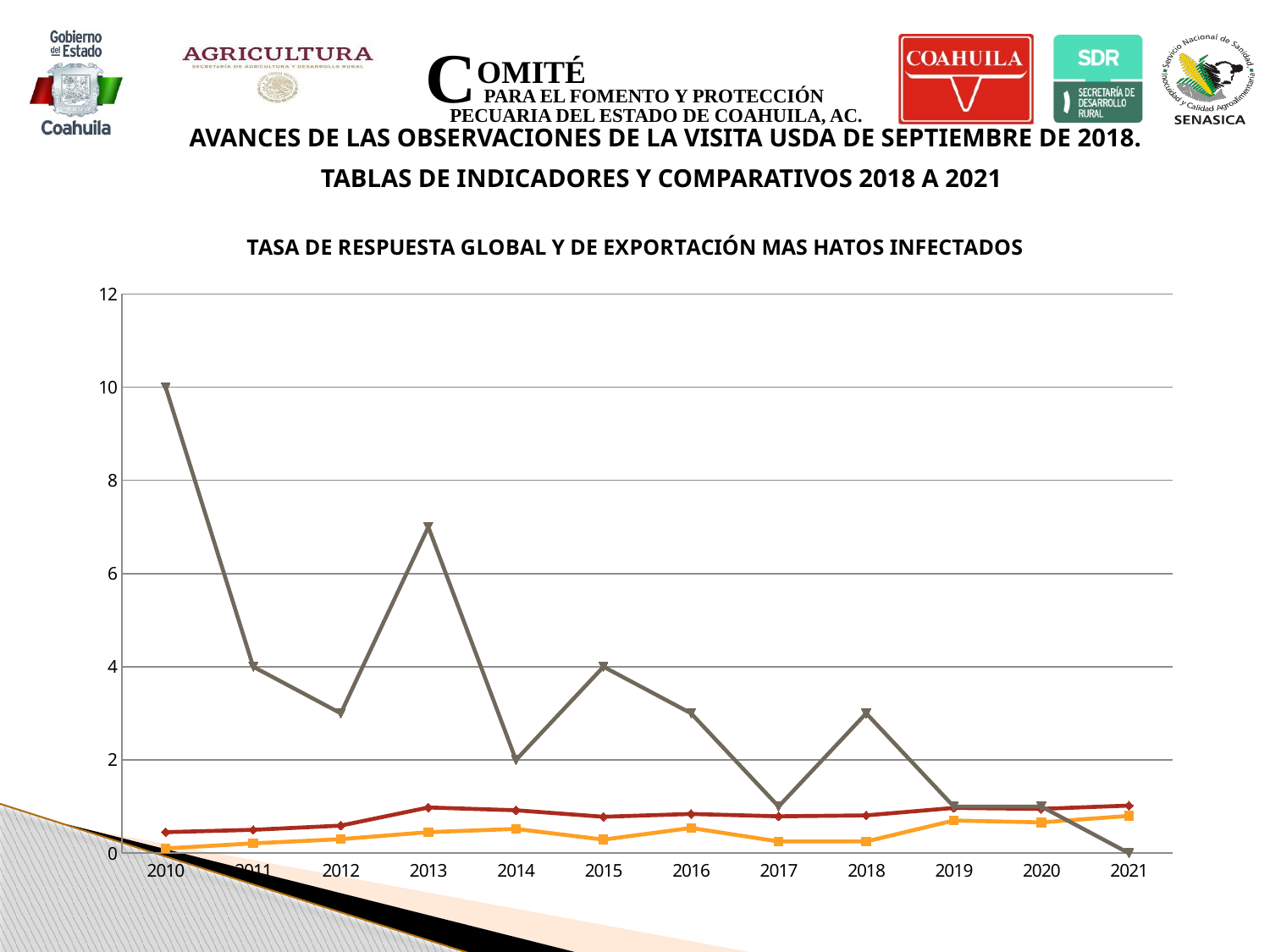
What type of chart is shown on the slide? Line chart What is the value of the gray line in 2010? 10 How many years are plotted along the x axis of the chart? 12 What is the value of the gray line in 2011? 4 Does the gray line generally rise or fall from 2010 to 2021? Fall In which year does the gray line reach its lowest value? 2021 What is the value of the gray line in 2014? 2 In which year does the gray line reach its highest value? 2010 What is the title of the chart? TASA DE RESPUESTA GLOBAL Y DE EXPORTACIÓN MAS HATOS INFECTADOS By how much does the gray line drop from 2010 to 2011? 6 What is the value of the gray line in 2021? 0 Is the value of the gray line in 2013 greater or less than 6? greater